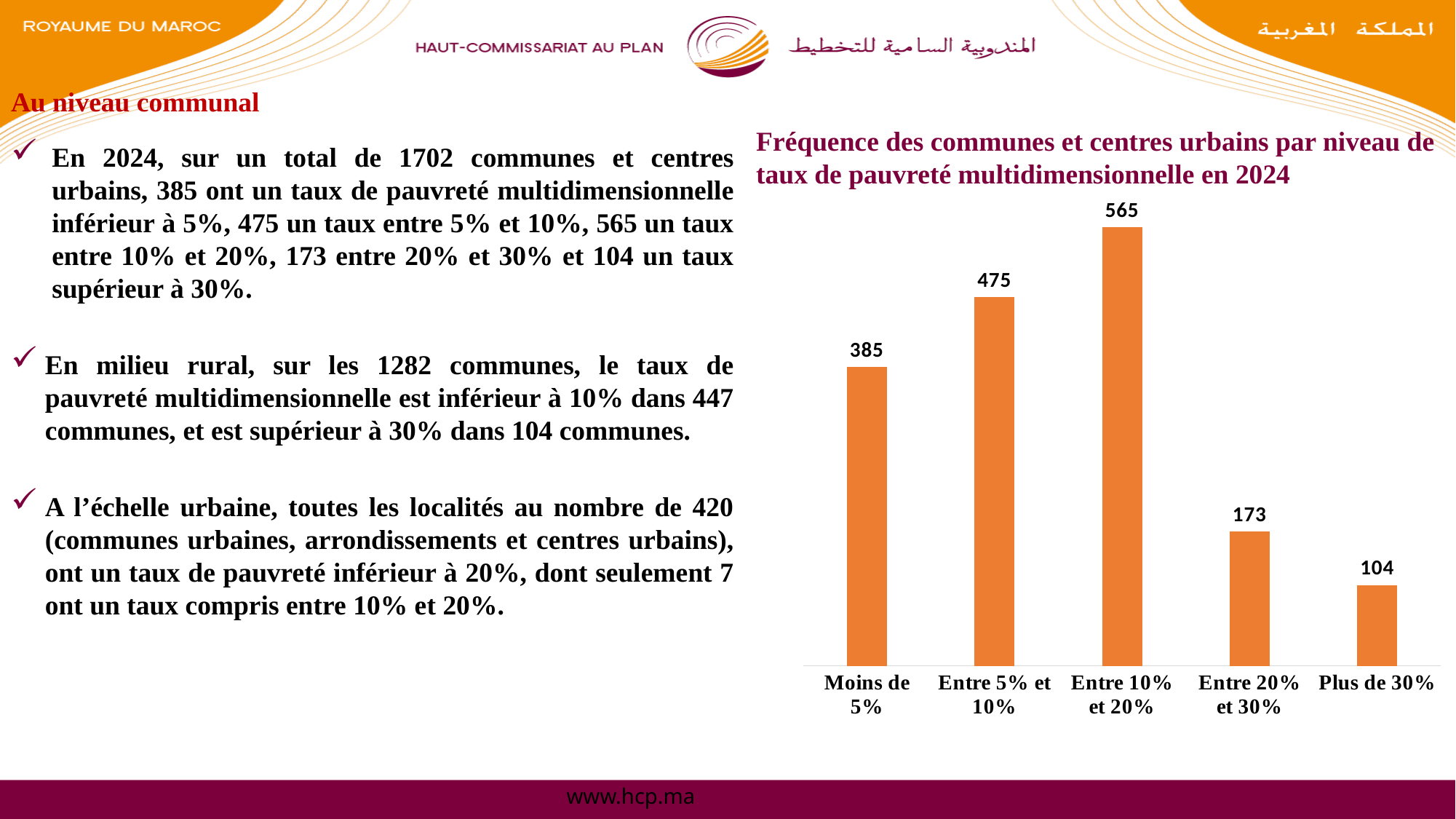
Which category has the highest value? Entre 10% et 20% What is the value for the 'Plus de 30%' category? 104 What is the title of the chart? Fréquence des communes et centres urbains par niveau de taux de pauvreté multidimensionnelle en 2024 Do the values rise or fall from 'Entre 10% et 20%' to 'Plus de 30%'? Fall What is the value for the 'Entre 10% et 20%' category? 565 What kind of chart is shown on the slide? Bar chart How many categories are shown on the chart? 5 What is the value for the 'Moins de 5%' category? 385 What is the difference between the values for 'Entre 20% et 30%' and 'Plus de 30%'? 69 Which category has the lowest value? Plus de 30% What is the difference between the values for 'Entre 10% et 20%' and 'Entre 5% et 10%'? 90 Which is larger, the value for 'Moins de 5%' or the value for 'Entre 5% et 10%'? Entre 5% et 10%